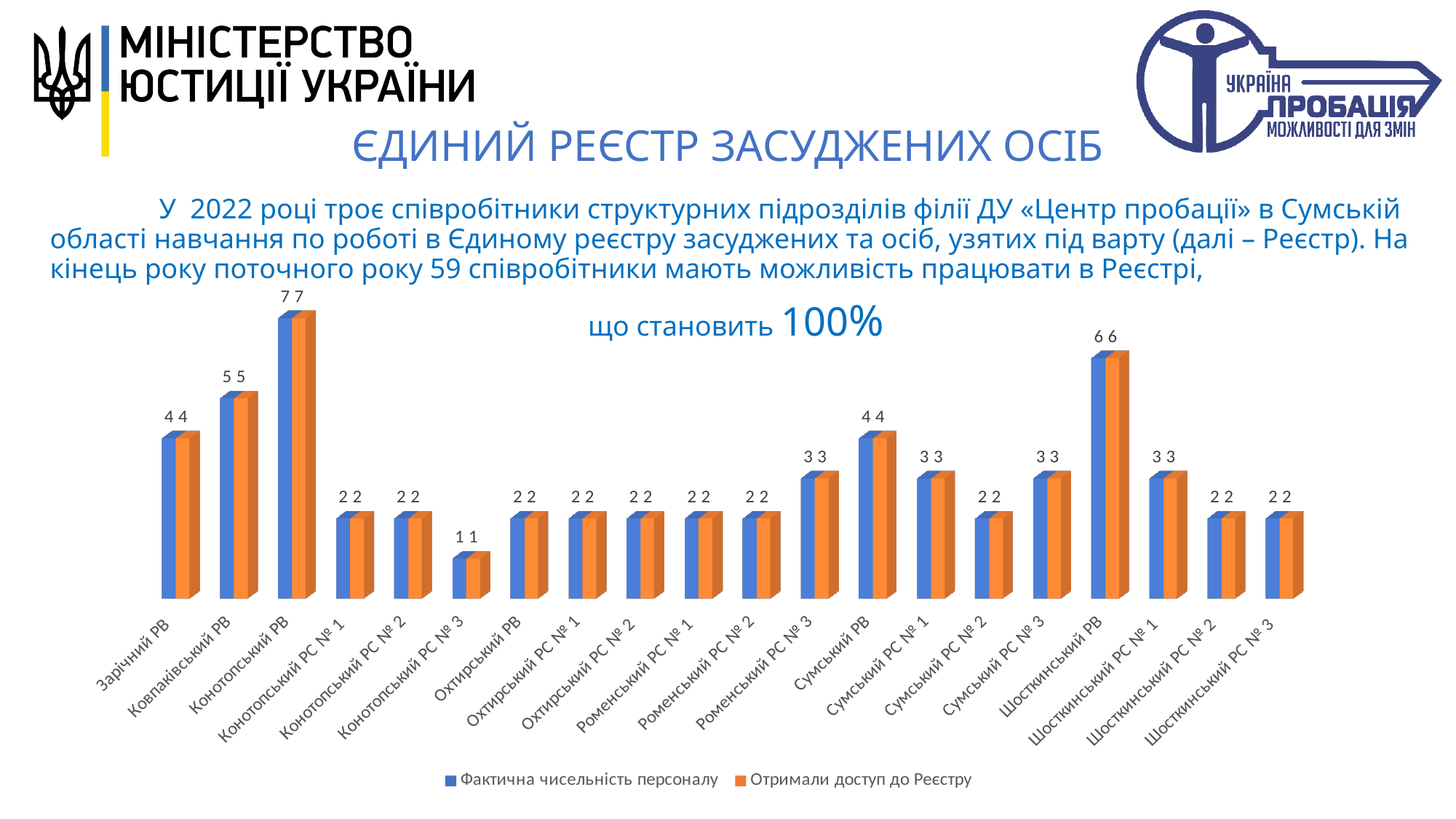
Which category has the highest value for "Фактична чисельність персоналу"? Конотопський РВ What is the value of "Фактична чисельність персоналу" for Конотопський РВ? 7 What is the value of "Отримали доступ до Реєстру" for Шосткинський РВ? 6 Which category has the lowest value for "Отримали доступ до Реєстру"? Конотопський РС № 3 How many categories are shown on the x axis of the chart? 20 Which is larger: the "Фактична чисельність персоналу" value for Сумський РВ or for Сумський РС № 1? Сумський РВ What is the value of "Фактична чисельність персоналу" for Ковпаківський РВ? 5 How many series does the chart legend list? 2 What type of chart is shown on the slide? Bar chart What is the value of "Отримали доступ до Реєстру" for Роменський РС № 3? 3 What is the difference between the "Фактична чисельність персоналу" values for Конотопський РВ and Шосткинський РВ? 1 Which series is shown in orange in the chart legend? Отримали доступ до Реєстру